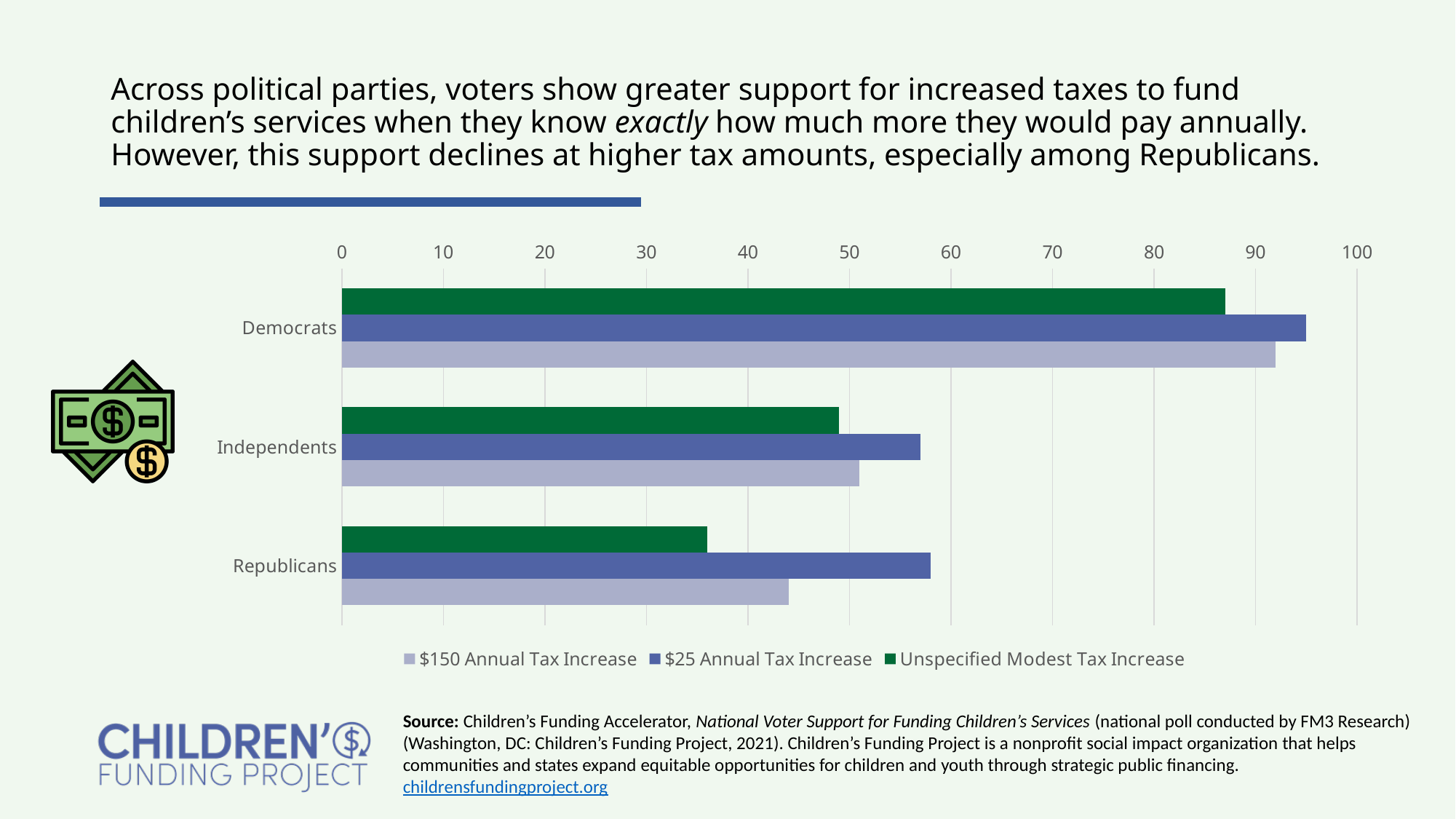
Is the value for Independents under $25 Annual Tax Increase greater or less than 50? greater Which series is shown in green in the chart legend? Unspecified Modest Tax Increase For Republicans, which is larger: the $25 Annual Tax Increase value or the Unspecified Modest Tax Increase value? $25 Annual Tax Increase Is the value for Republicans under $150 Annual Tax Increase greater or less than 50? less Which party has the highest value for $25 Annual Tax Increase? Democrats Is the value for Democrats under Unspecified Modest Tax Increase greater or less than 80? greater Which party has the lowest value for Unspecified Modest Tax Increase? Republicans How many political party categories are plotted on the chart? 3 How many series does the chart legend list? 3 What kind of chart is shown on the slide? bar chart